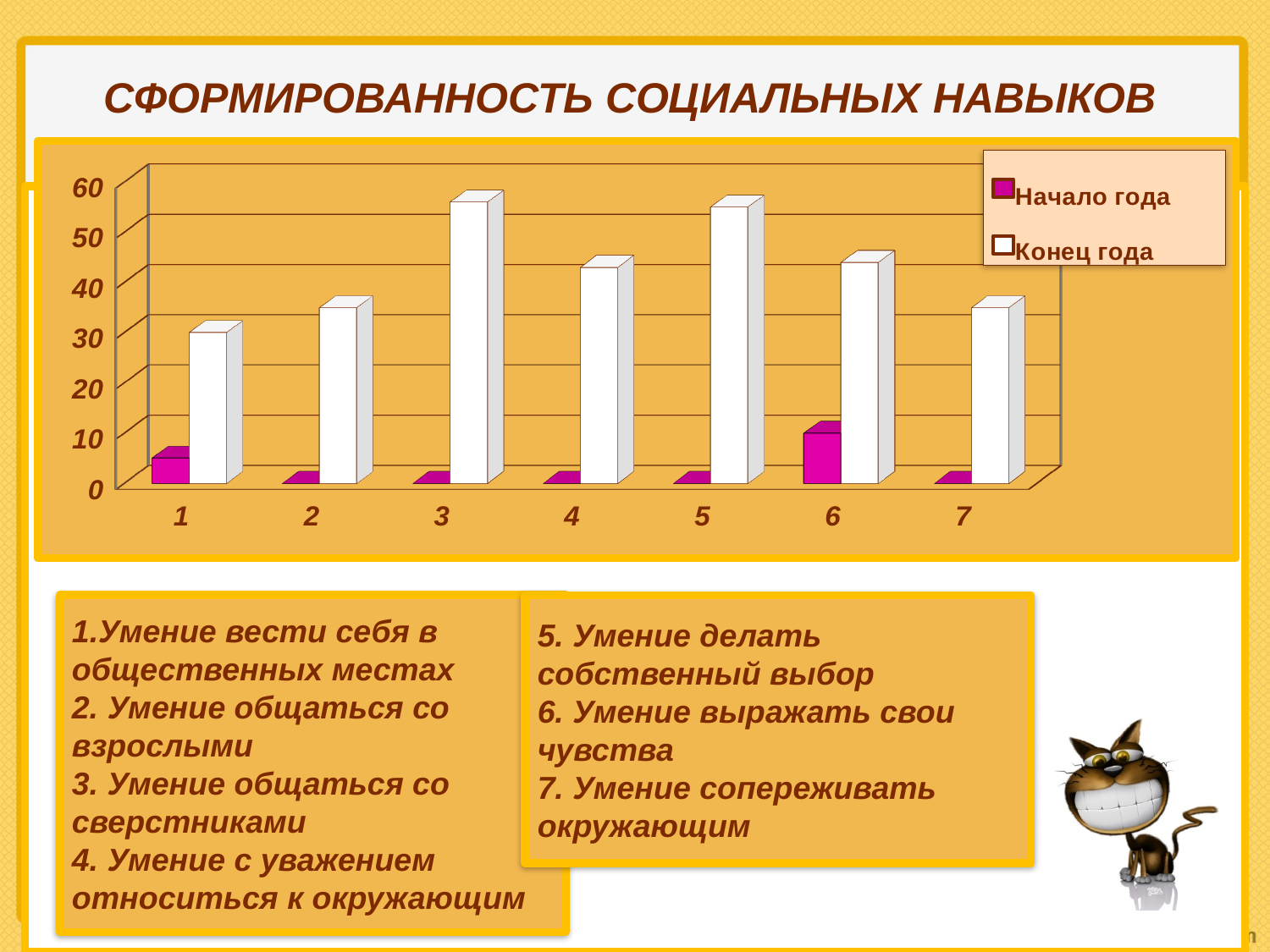
What kind of chart is shown on the slide? bar chart Is the Начало года value for category 6 greater or less than 5? greater Is the Конец года value for category 3 greater or less than 50? greater What is the title of the slide above the chart? СФОРМИРОВАННОСТЬ СОЦИАЛЬНЫХ НАВЫКОВ For the series Конец года, which is larger: category 3 or category 2? category 3 How many categories are shown along the x axis of the chart? 7 For the series Начало года, which is larger: category 6 or category 1? category 6 For the series Начало года, which category has the highest bar? 6 How many series does the chart legend list? 2 For the series Конец года, which category has the lowest bar? 1 Is the Конец года value for category 1 greater or less than 40? less What are the two series named in the chart legend? Начало года, Конец года